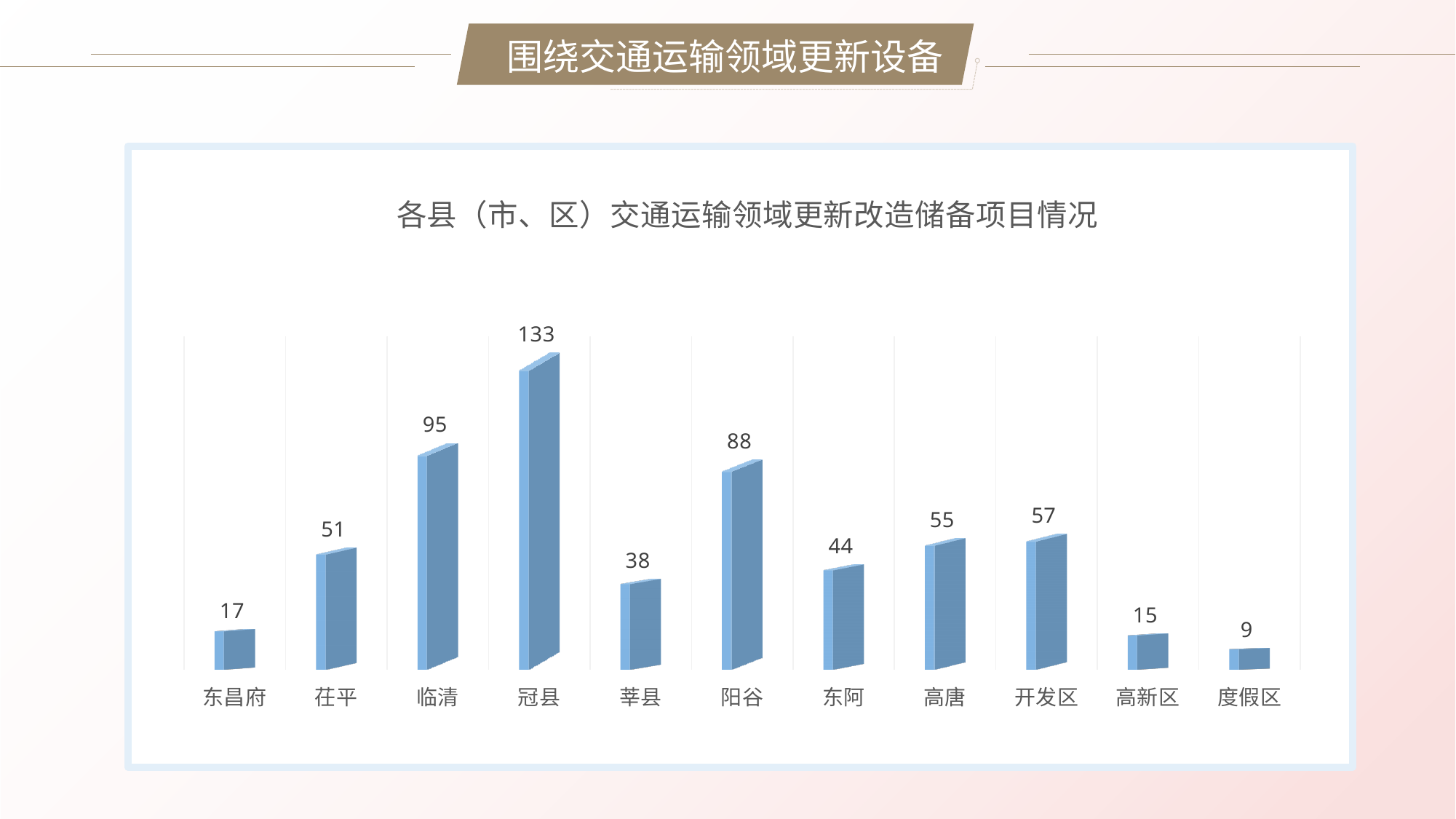
Which is larger, the value for 高唐 or the value for 东阿? 高唐 What is the value for 开发区? 57 What is the value for 东昌府? 17 What is the value for 冠县? 133 What kind of chart is this? bar chart How many categories are shown on the x axis? 11 What is the value for 阳谷? 88 Which category has the lowest value? 度假区 What is the difference between the values for 冠县 and 阳谷? 45 What is the difference between the values for 临清 and 茌平? 44 What is the title of the chart? 各县（市、区）交通运输领域更新改造储备项目情况 Which category has the highest value? 冠县